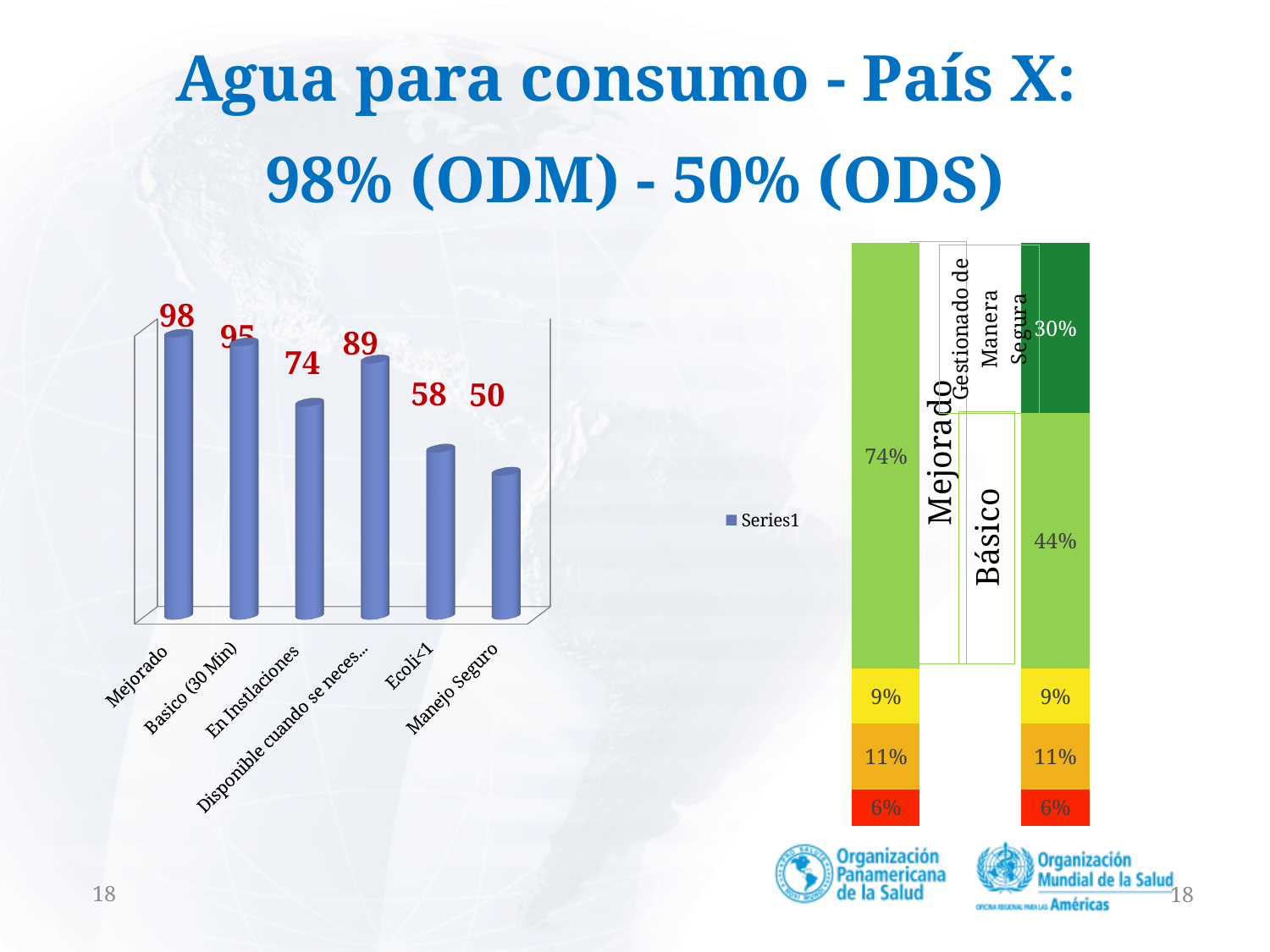
In the left bar chart, which category has the lowest value? Manejo Seguro In the left bar chart, what is the value for Ecoli<1? 58 In the left bar chart, which is larger, the value for En Instlaciones or the value for Ecoli<1? En Instlaciones In the left bar chart, which category has the highest value? Mejorado How many series does the legend of the left chart list? 1 In the right stacked chart, what is the largest segment value shown in the left-hand stacked bar? 74% What kind of chart is the chart on the left of the slide? Bar chart In the right stacked chart, what is the total of the segments in the right-hand stacked bar (30%, 44%, 9%, 11%, 6%)? 100% In the left bar chart, what is the difference between the values for Mejorado and Manejo Seguro? 48 In the left bar chart, what is the value for Manejo Seguro? 50 In the left bar chart, what is the value for Mejorado? 98 How many categories are shown in the left bar chart? 6